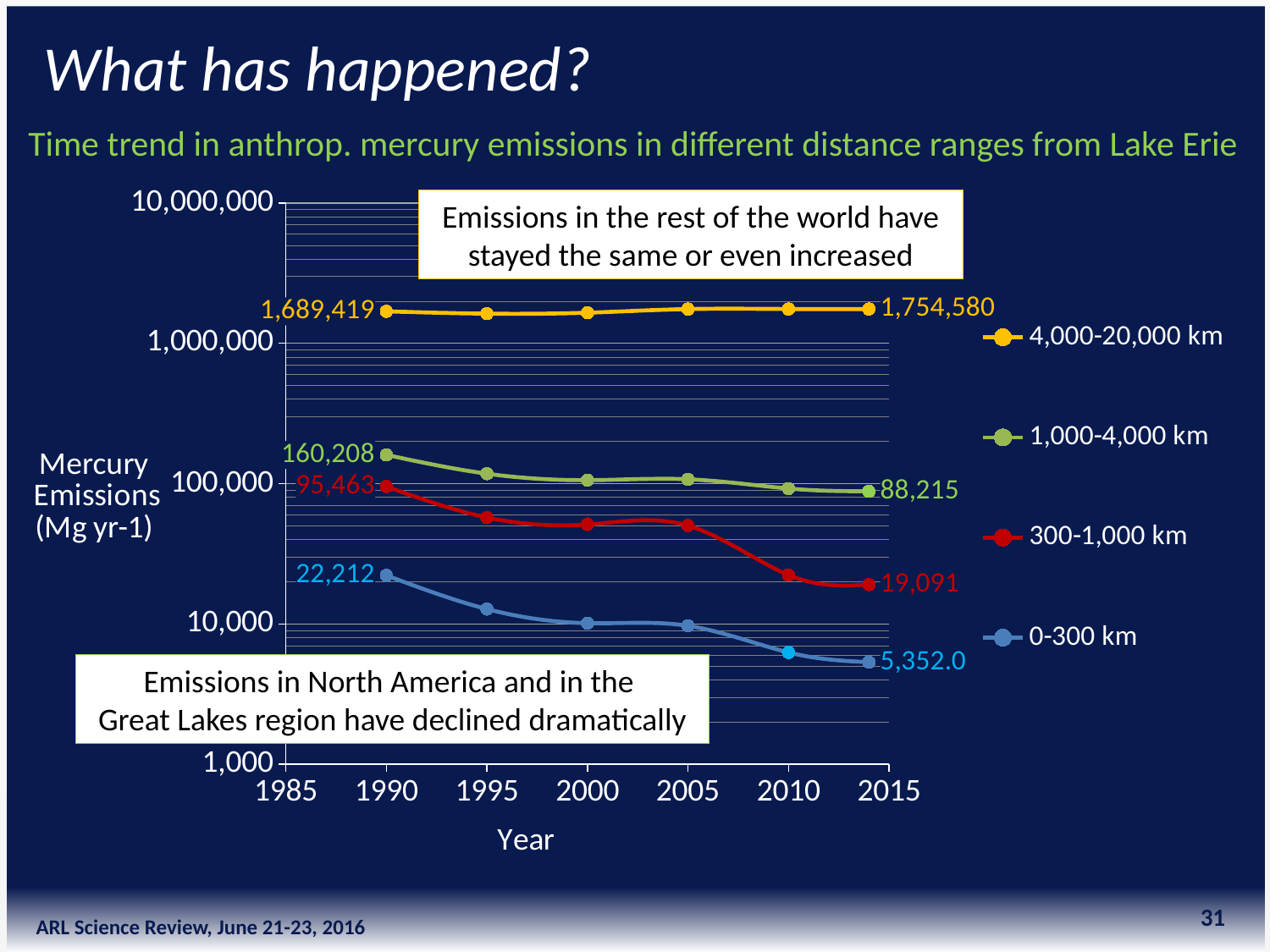
By how much did the 1,000-4,000 km series decline from its first labelled value (160,208) to its last labelled value (88,215)? 71,993 Does the 0-300 km series rise or fall over the years shown? fall What is the labelled value of the 1,000-4,000 km series at its last data point? 88,215 What is the labelled value of the 0-300 km series at its last data point? 5,352.0 Is the value for the 0-300 km series in 2010 greater or less than 10,000? less What is the labelled value of the 300-1,000 km series at its first data point (1990)? 95,463 Which series has the lowest mercury emissions throughout the chart? 0-300 km For the 4,000-20,000 km series, which is larger: the first labelled value or the last labelled value? the last labelled value (1,754,580) Which series has the highest mercury emissions throughout the chart? 4,000-20,000 km What type of chart is shown on the slide? line chart How many series does the chart legend list? 4 What is the labelled value of the 4,000-20,000 km series at its first data point (1990)? 1,689,419